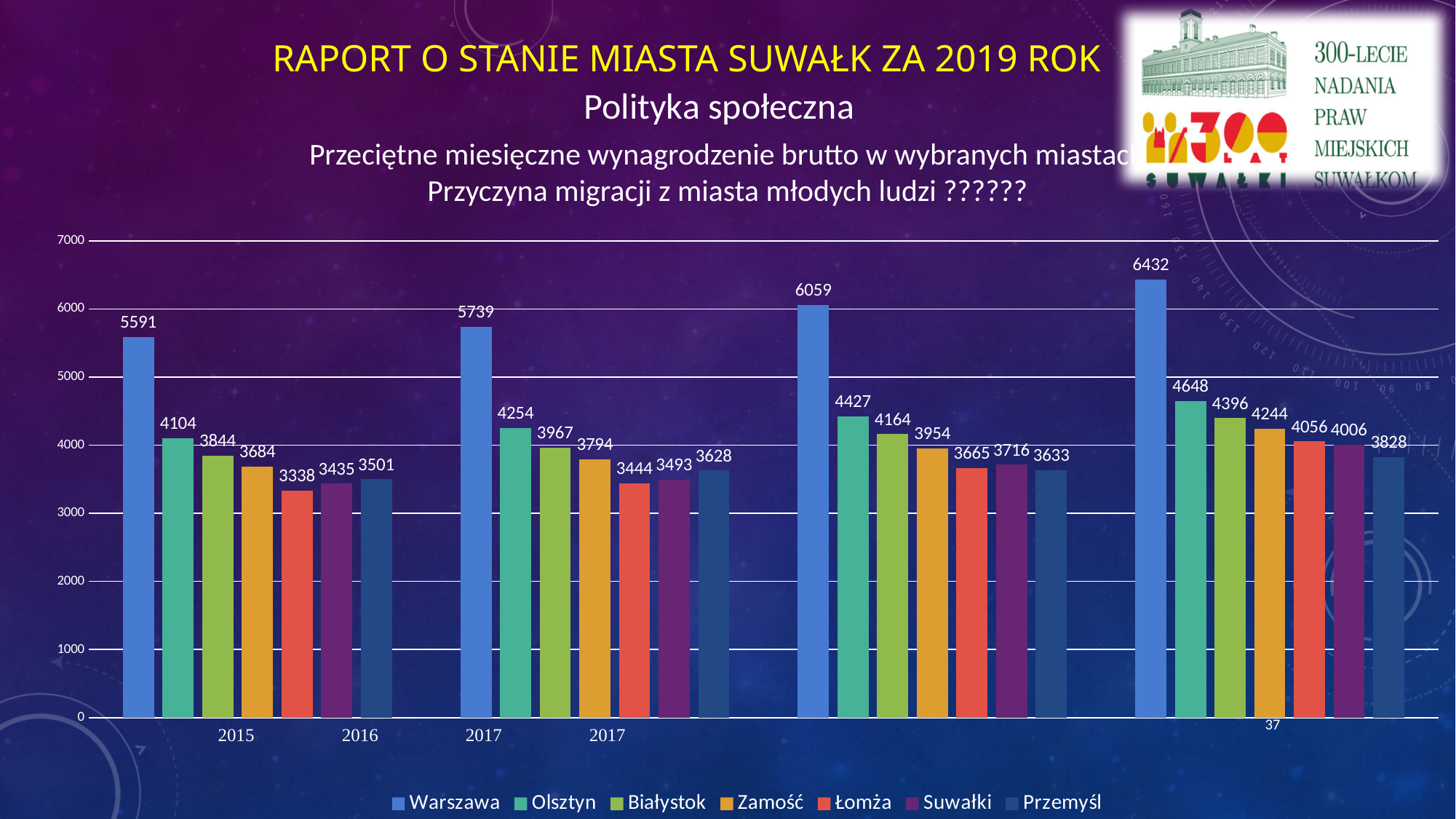
What is the value for Suwałki in the fourth group of bars from the left? 4006 How many groups of bars are plotted on the chart? 4 How many series does the legend list? 7 Which city has the highest value in the fourth group of bars from the left? Warszawa Which series is shown in blue in the legend? Warszawa What kind of chart is shown on the slide? bar chart Which city has the lowest value in the first group of bars from the left? Łomża In the third group of bars from the left, which is larger: Suwałki or Przemyśl? Suwałki What is the value for Olsztyn in the third group of bars from the left? 4427 Do the values for Warszawa rise or fall from the first group to the fourth group? rise What is the difference between Warszawa and Suwałki in the fourth group of bars from the left? 2426 What is the value for Warszawa in the first group of bars from the left? 5591